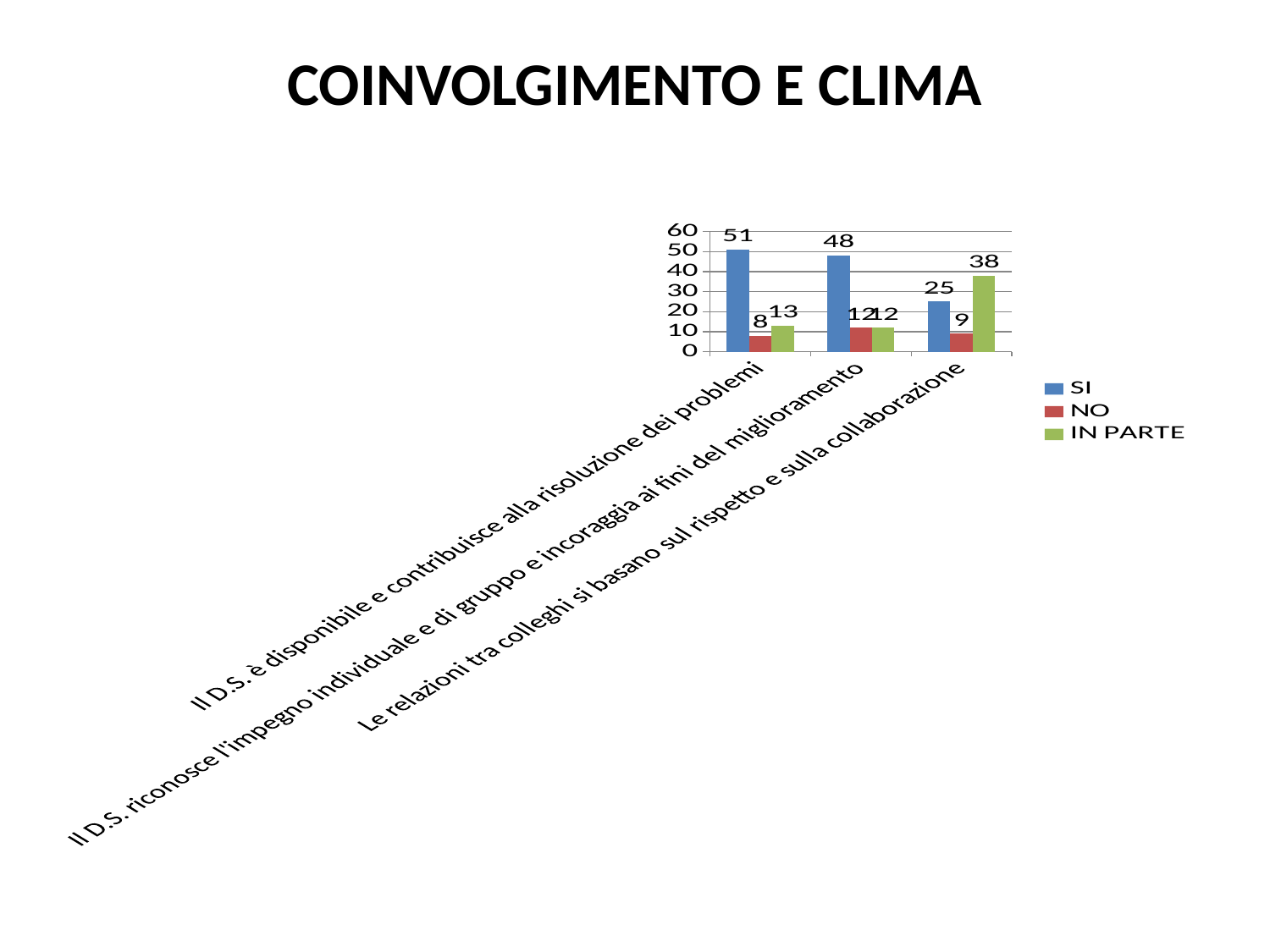
What is the NO value for "Il D.S. riconosce l'impegno individuale e di gruppo e incoraggia ai fini del miglioramento"? 12 Which category has the highest SI value? Il D.S. è disponibile e contribuisce alla risoluzione dei problemi For "Le relazioni tra colleghi si basano sul rispetto e sulla collaborazione", which is larger: SI or IN PARTE? IN PARTE What is the SI value for "Il D.S. è disponibile e contribuisce alla risoluzione dei problemi"? 51 What is the title of the slide containing the chart? COINVOLGIMENTO E CLIMA What is the difference between the SI and IN PARTE values for "Le relazioni tra colleghi si basano sul rispetto e sulla collaborazione"? 13 How many categories are shown on the x axis? 3 Is the SI value for "Il D.S. riconosce l'impegno individuale e di gruppo e incoraggia ai fini del miglioramento" greater or less than 40? greater How many series does the legend list? 3 What type of chart is shown on the slide? bar chart Which category has the lowest NO value? Il D.S. è disponibile e contribuisce alla risoluzione dei problemi What is the IN PARTE value for "Le relazioni tra colleghi si basano sul rispetto e sulla collaborazione"? 38